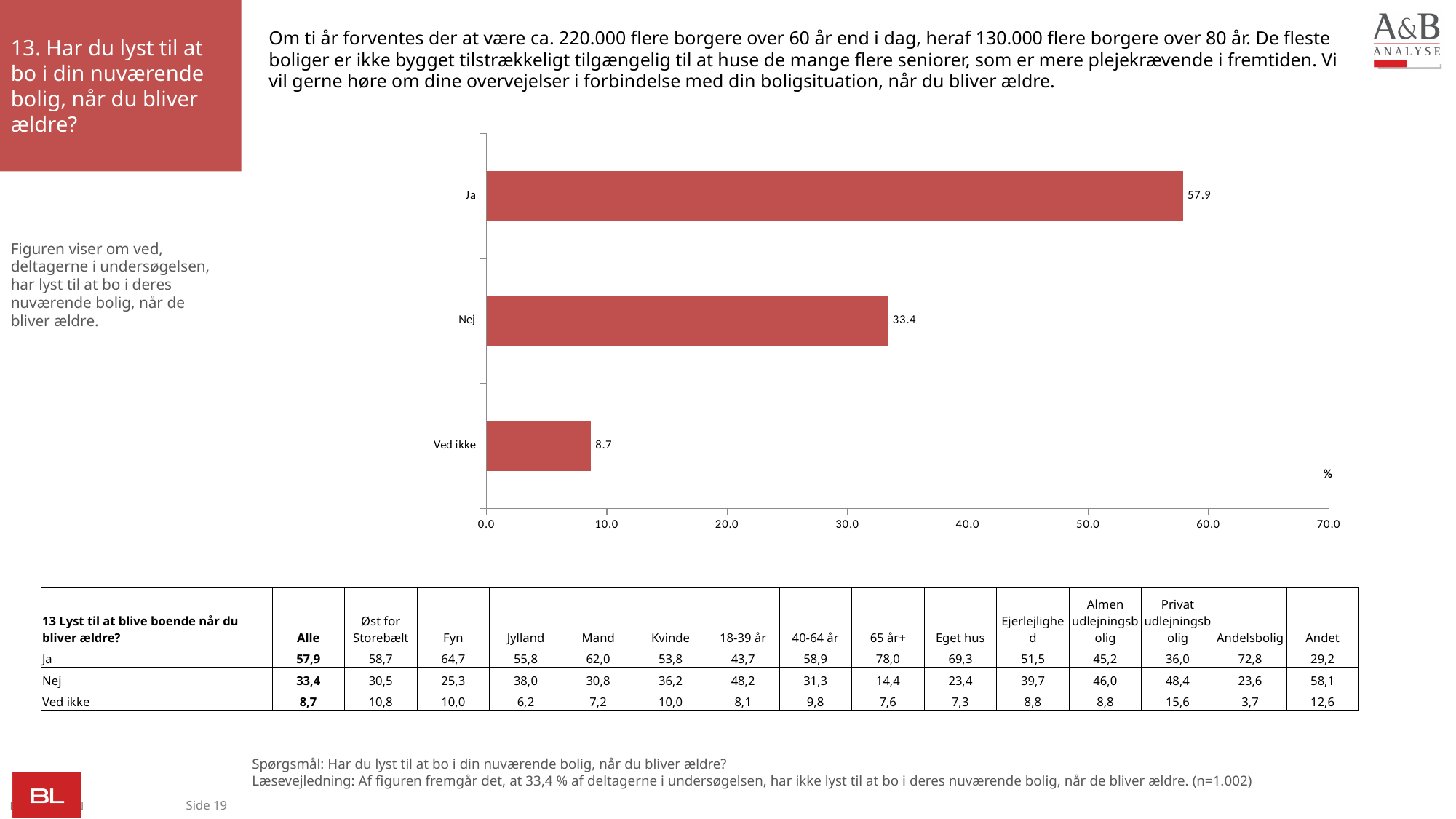
Which is larger, the value for Nej or the value for Ved ikke? Nej What is the difference between the values for Nej and Ved ikke? 24.7 Which category has the highest value? Ja Which category has the lowest value? Ved ikke Is the value for Ja greater or less than 50.0? greater What is the value for Ved ikke? 8.7 What is the value for Ja? 57.9 What is the maximum value shown on the x axis? 70.0 What kind of chart is shown on the slide? bar chart How many categories are shown in the chart? 3 What is the value for Nej? 33.4 What is the difference between the values for Ja and Nej? 24.5